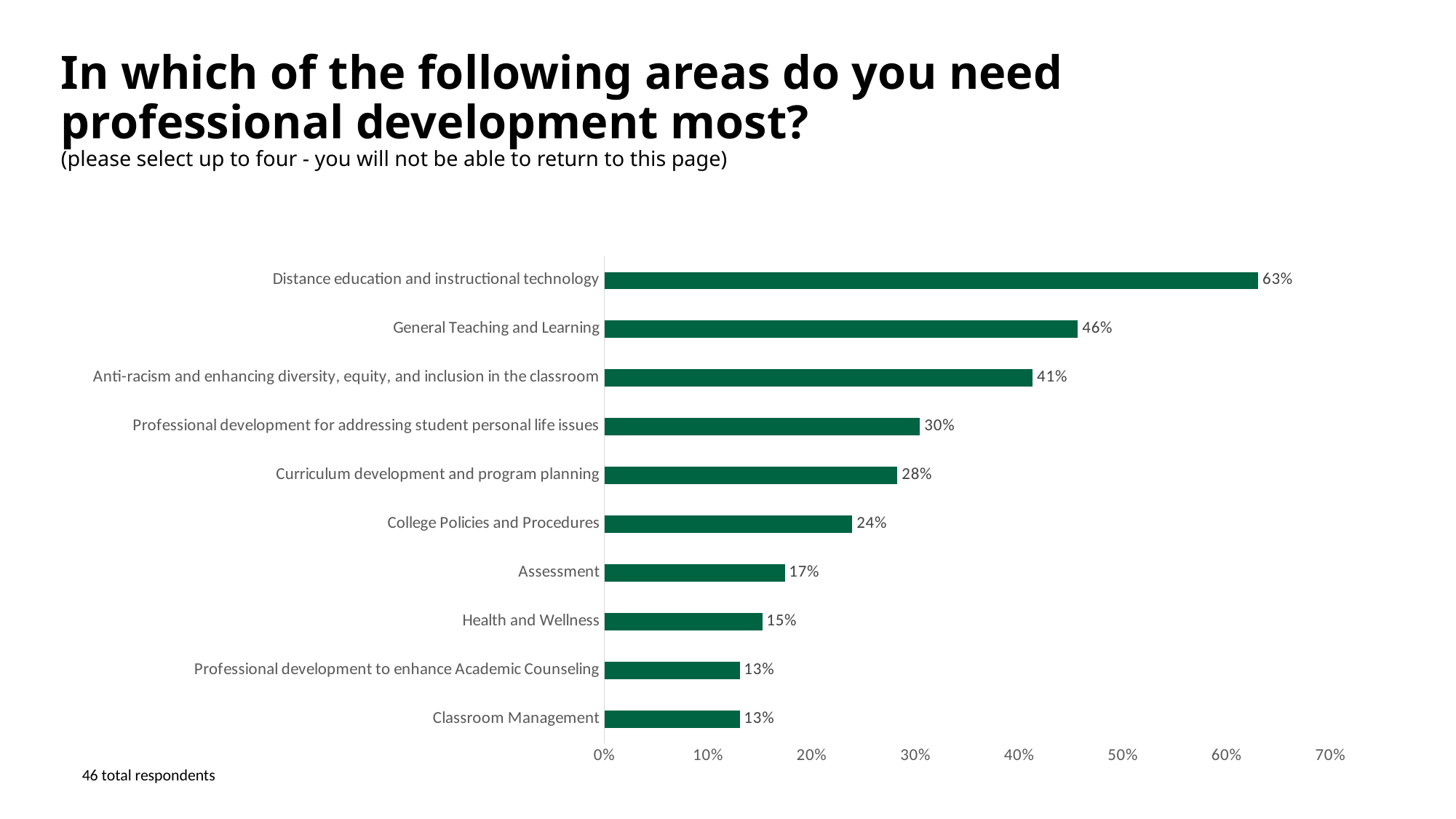
What is the value for General Teaching and Learning? 46% Which area has the highest percentage? Distance education and instructional technology Which is larger, the value for Curriculum development and program planning or the value for College Policies and Procedures? Curriculum development and program planning What percentage is shown for College Policies and Procedures? 24% Is the value for Professional development for addressing student personal life issues greater or less than 20%? greater How many areas are shown in the chart? 10 What kind of chart is shown on the slide? Bar chart What is the difference between the values for Anti-racism and enhancing diversity, equity, and inclusion in the classroom and Assessment? 24% What is the difference between the values for Distance education and instructional technology and General Teaching and Learning? 17% How many total respondents are noted on the slide? 46 What percentage of respondents selected Distance education and instructional technology? 63% What is the value for Health and Wellness? 15%